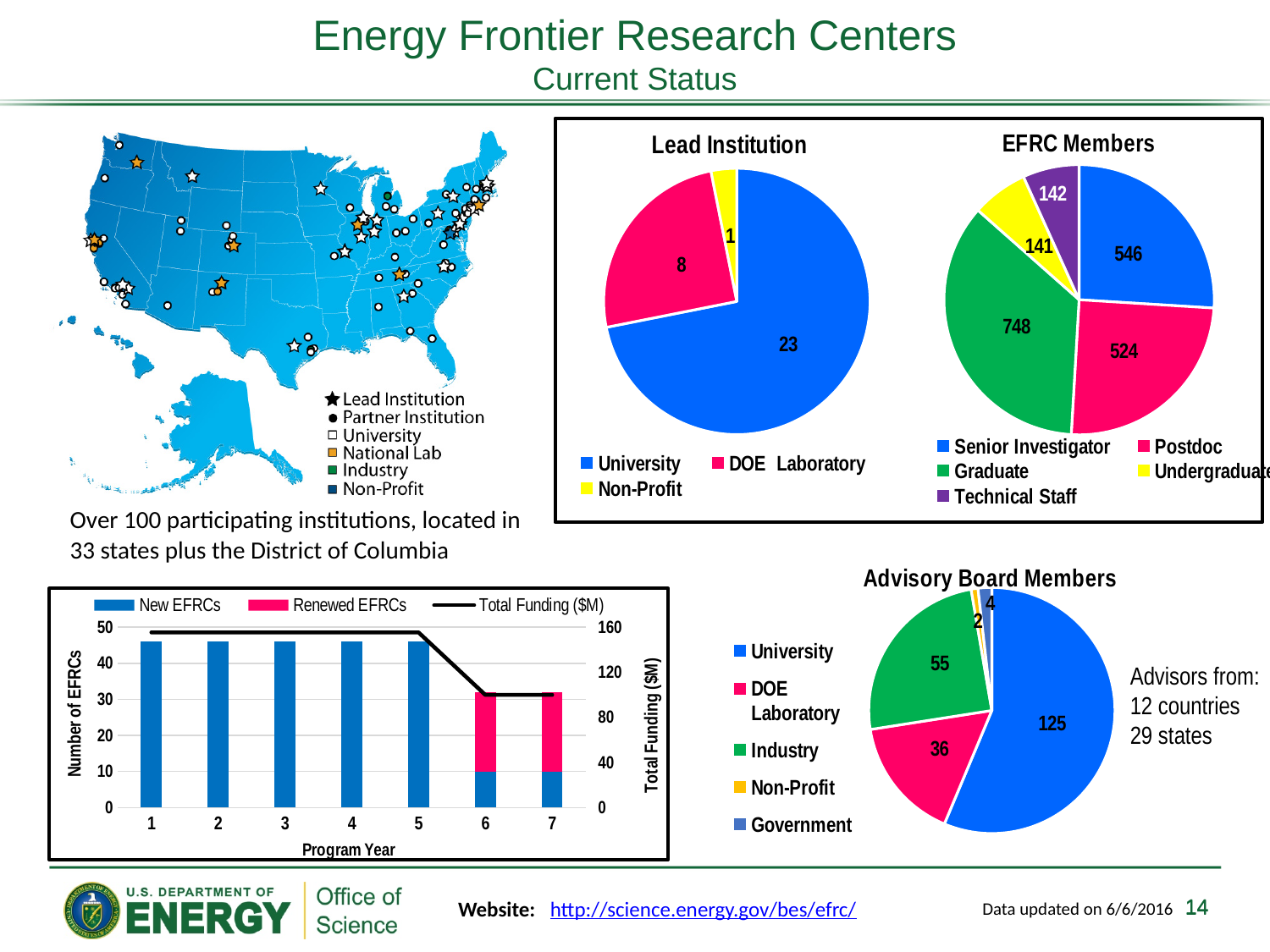
In the Advisory Board Members pie chart, which is larger, DOE Laboratory or Industry? Industry In the Lead Institution pie chart, what is the value for DOE Laboratory? 8 In the bar chart at the bottom left, is the number of New EFRCs in Program Year 6 greater or less than 20? less In the EFRC Members pie chart, what is the value for Graduate? 748 In the Lead Institution pie chart, which category has the smallest slice? Non-Profit In the Advisory Board Members pie chart, what is the value for Industry? 55 In the bar chart at the bottom left, how many series does the legend list? 3 In the EFRC Members pie chart, what is the difference between the Graduate and Senior Investigator values? 202 In the Lead Institution pie chart, how many lead institutions are universities? 23 In the Advisory Board Members pie chart, which category has the smallest value? Non-Profit In the EFRC Members pie chart, which category has the largest value? Graduate In the EFRC Members pie chart, how many categories does the legend list? 5